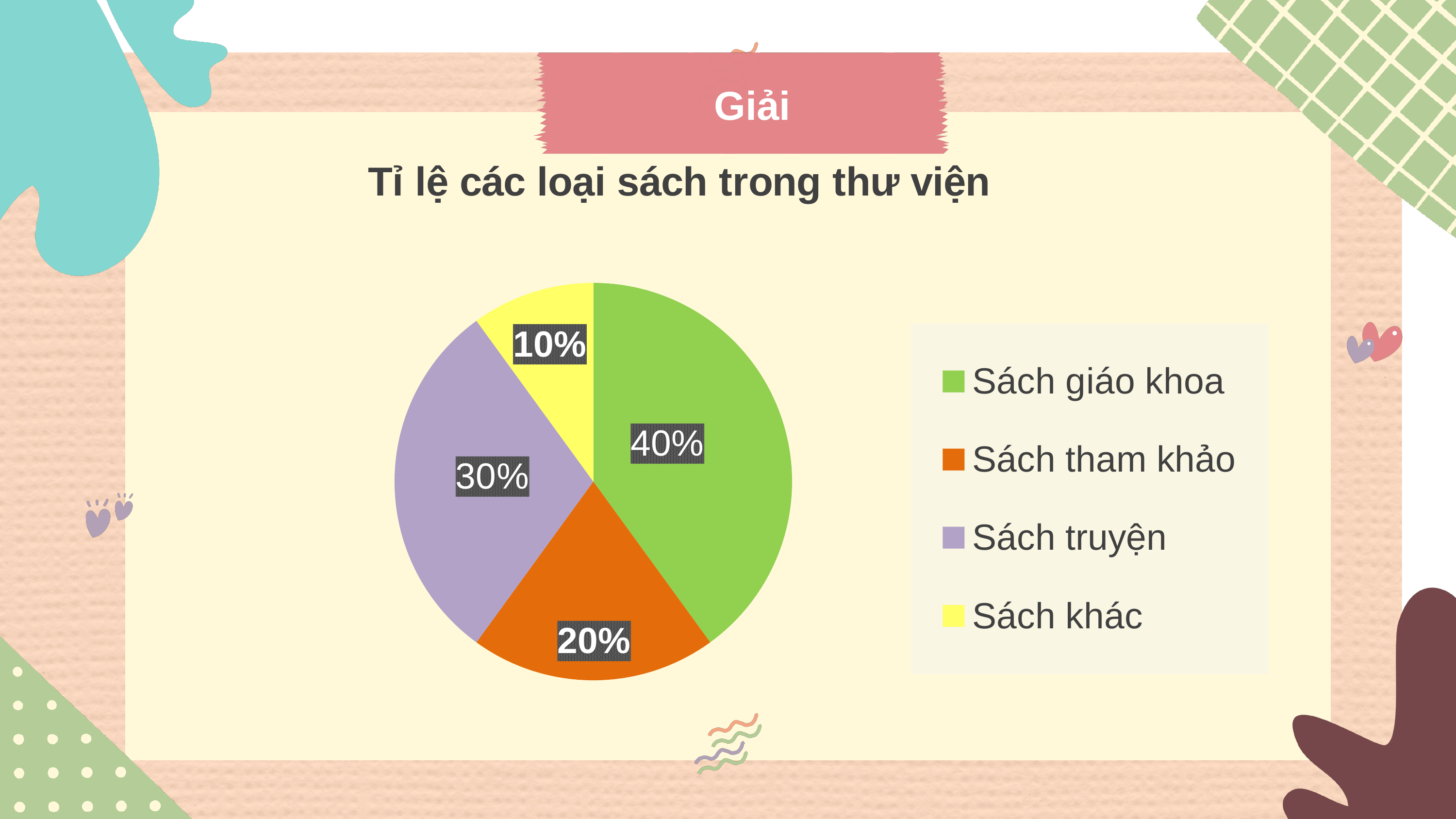
What percentage of the pie chart is Sách tham khảo? 20% What is the title of the chart? Tỉ lệ các loại sách trong thư viện Which category has the smallest share of the pie chart? Sách khác Which is larger: the share for Sách tham khảo or the share for Sách truyện? Sách truyện How many categories are shown in the pie chart? 4 What percentage of the pie chart is Sách giáo khoa? 40% What is the difference in percentage points between Sách giáo khoa and Sách truyện? 10% What type of chart is shown on the slide? Pie chart What colour is the slice for Sách truyện? Purple What percentage of the pie chart is Sách truyện? 30% What percentage of the pie chart is Sách khác? 10% Which category has the largest share of the pie chart? Sách giáo khoa